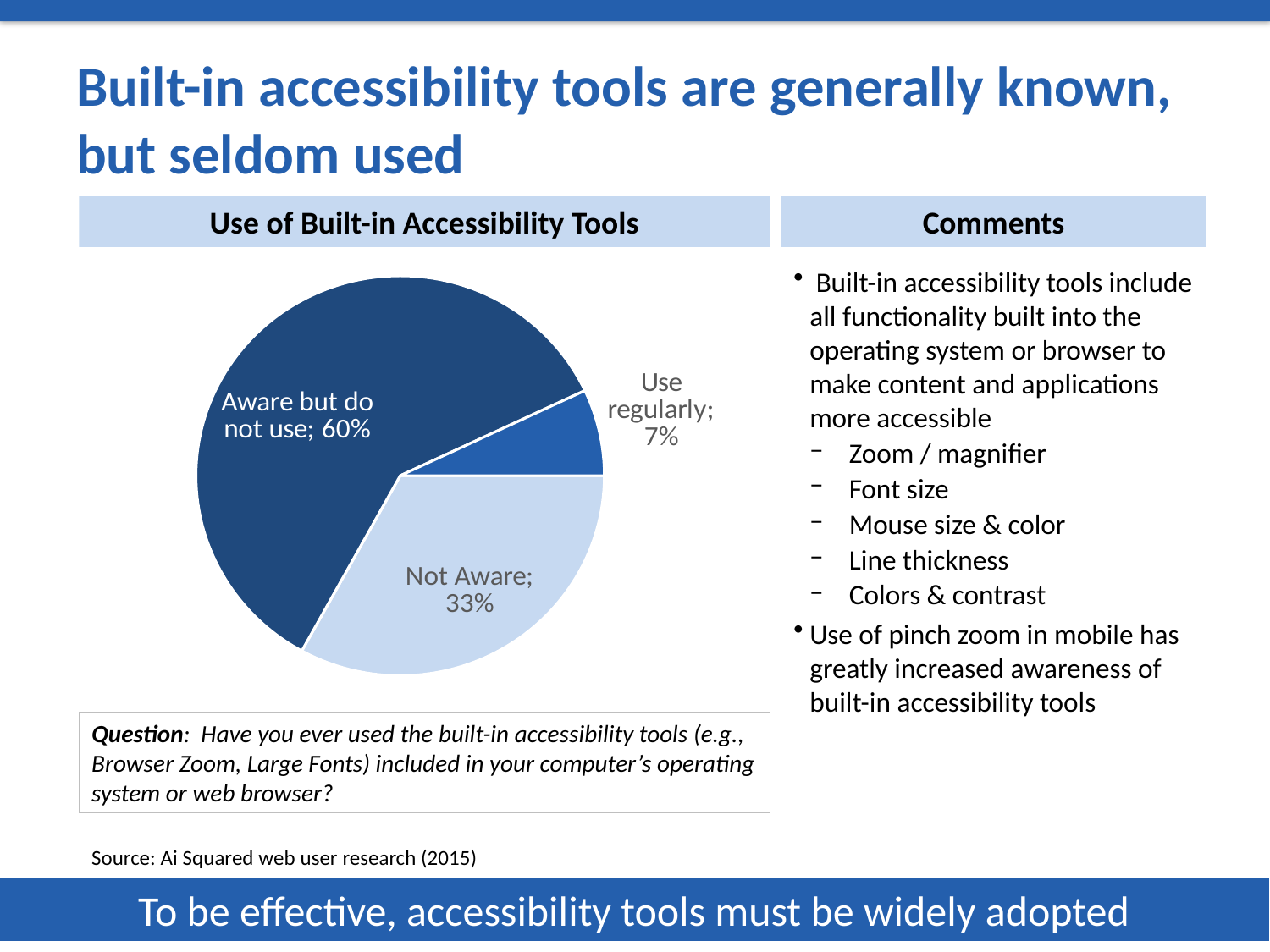
Which is larger: the "Not Aware" slice or the "Use regularly" slice? Not Aware What is the difference in percentage points between "Aware but do not use" and "Not Aware"? 27 What percentage of respondents are "Aware but do not use"? 60% What is the title of the pie chart? Use of Built-in Accessibility Tools What is the difference in percentage points between "Not Aware" and "Use regularly"? 26 What percentage of respondents are "Not Aware"? 33% What kind of chart is shown under "Use of Built-in Accessibility Tools"? pie chart Which slice of the pie is the smallest? Use regularly What is the source cited for the chart data? Ai Squared web user research (2015) What percentage of respondents "Use regularly"? 7% How many slices does the pie chart have? 3 Which slice of the pie is the largest? Aware but do not use